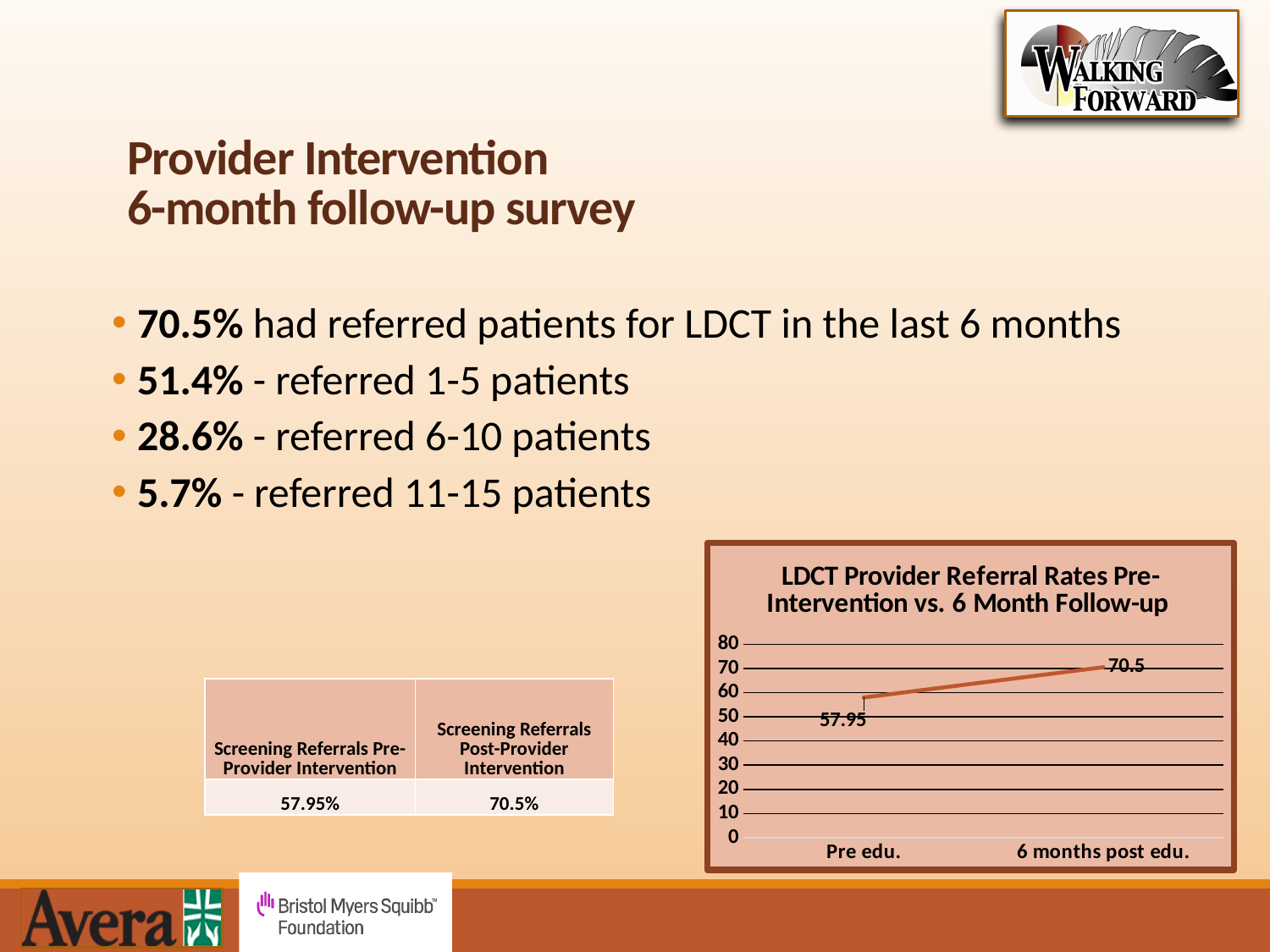
Which category has the lowest value in the chart? Pre edu. Do the values rise or fall from Pre edu. to 6 months post edu.? rise What is the difference between the 6 months post edu. value and the Pre edu. value? 12.55 Is the value for 6 months post edu. greater or less than 70? greater Is the value for Pre edu. greater or less than 60? less How many categories are shown on the x axis of the chart? 2 Which is larger, the value for Pre edu. or the value for 6 months post edu.? 6 months post edu. Which category has the highest value in the chart? 6 months post edu. What is the value for 6 months post edu. in the chart? 70.5 What kind of chart is shown on the slide? line chart What is the title of the chart? LDCT Provider Referral Rates Pre-Intervention vs. 6 Month Follow-up What is the value for Pre edu. in the chart? 57.95